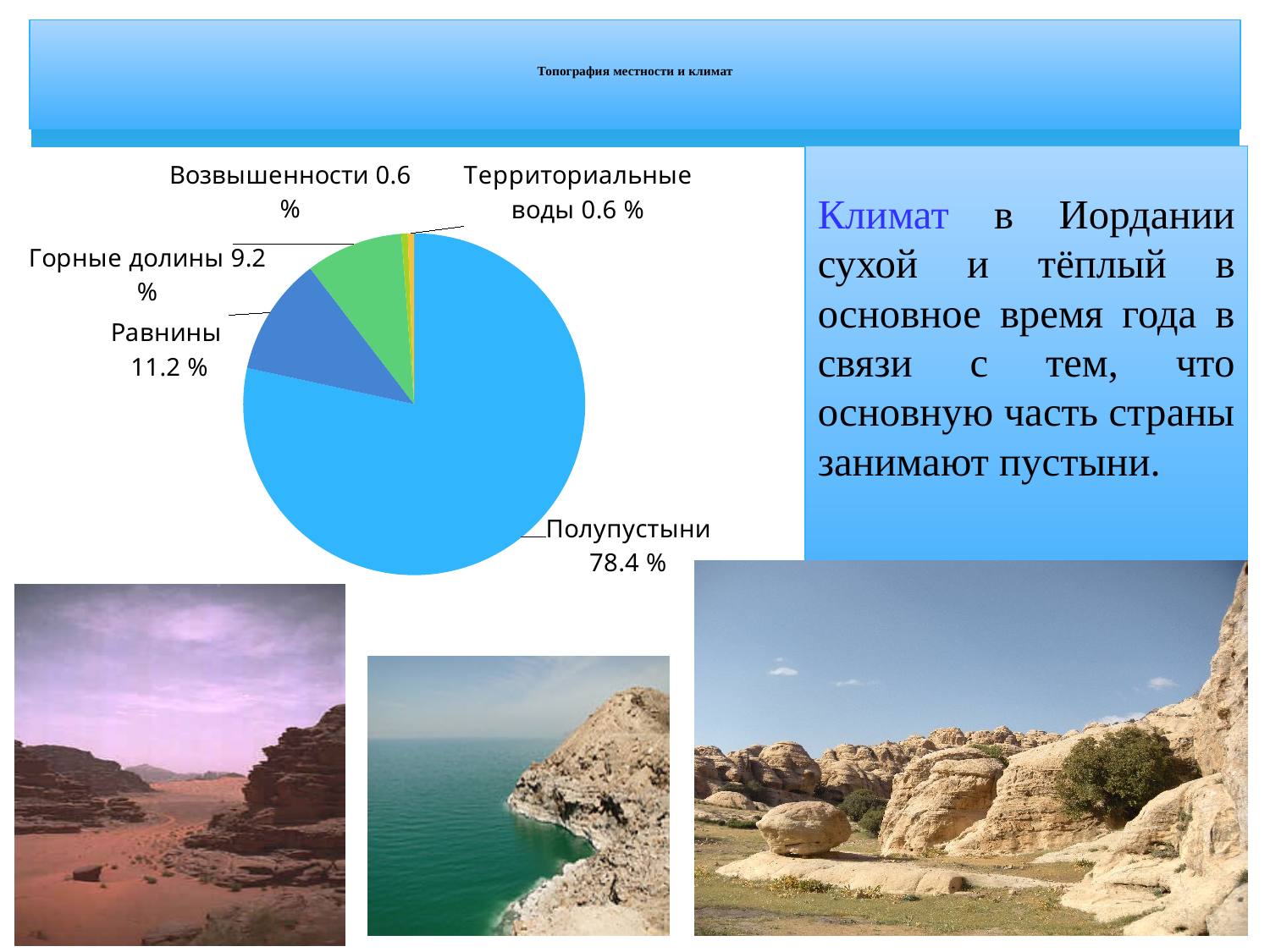
Which category has the largest slice of the pie? Полупустыни What colour is the Горные долины slice? green What is the value shown for Возвышенности? 0.6 % What kind of chart is shown on the slide? pie chart What is the difference between the values for Полупустыни and Равнины? 67.2 % What is the value shown for Горные долины? 9.2 % Which is larger, Равнины or Горные долины? Равнины What is the value shown for Территориальные воды? 0.6 % How many slices does the pie chart have? 5 What is the difference between the values for Полупустыни and Горные долины? 69.2 % What is the value shown for Равнины? 11.2 % What share of the pie does Полупустыни take? 78.4 %